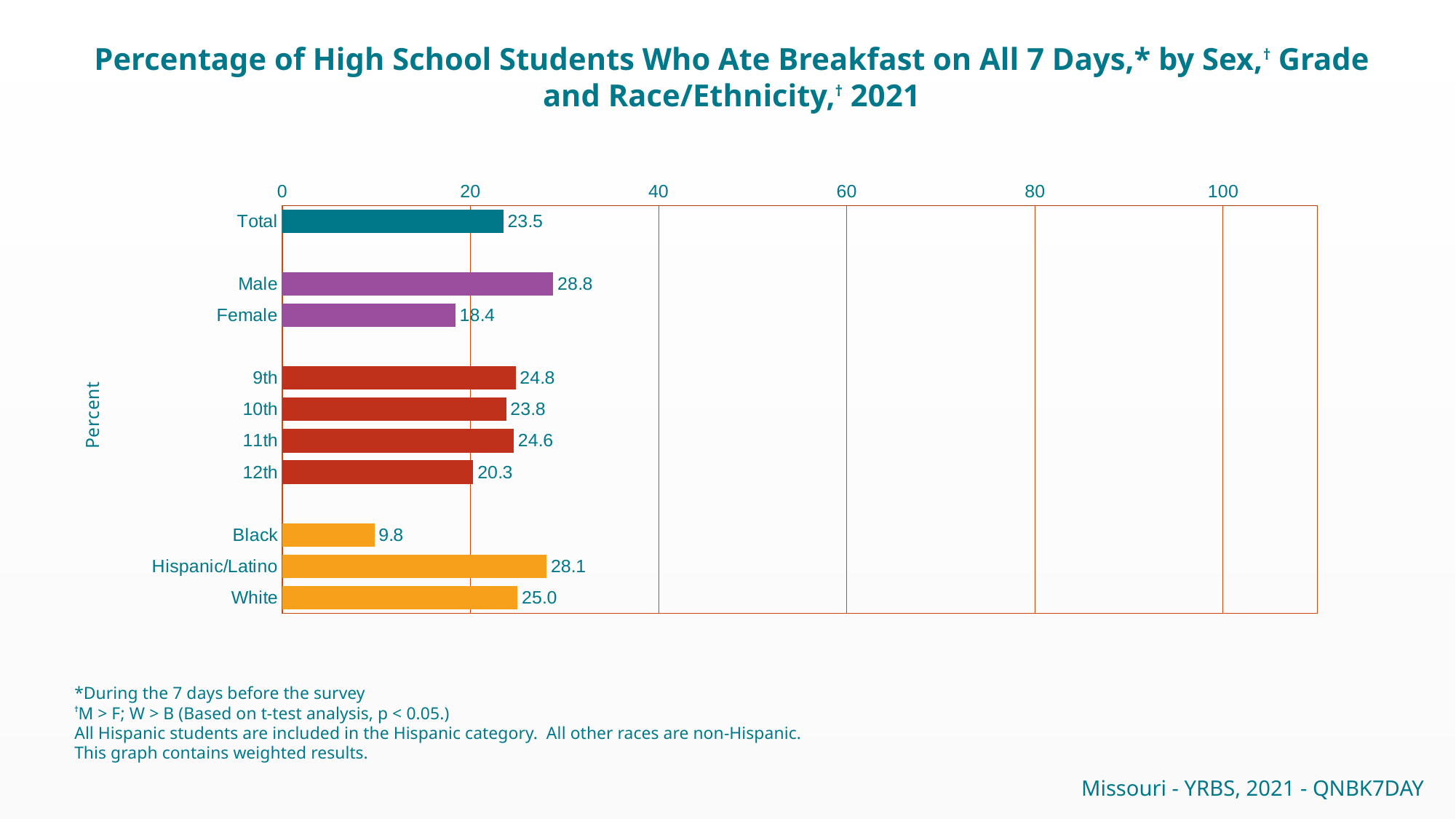
What is the value for 12th grade? 20.3 What is the value for Total? 23.5 What is the difference between the White and Black values? 15.2 Which category has the highest value? Male What is the value for Hispanic/Latino? 28.1 Is the value for Black greater or less than 20? less Which category has the lowest value? Black What is the value for Female? 18.4 What kind of chart is shown on the slide? bar chart Which is larger, the value for 9th grade or 12th grade? 9th What is the difference between the Male and Female values? 10.4 How many categories are plotted on the chart? 10